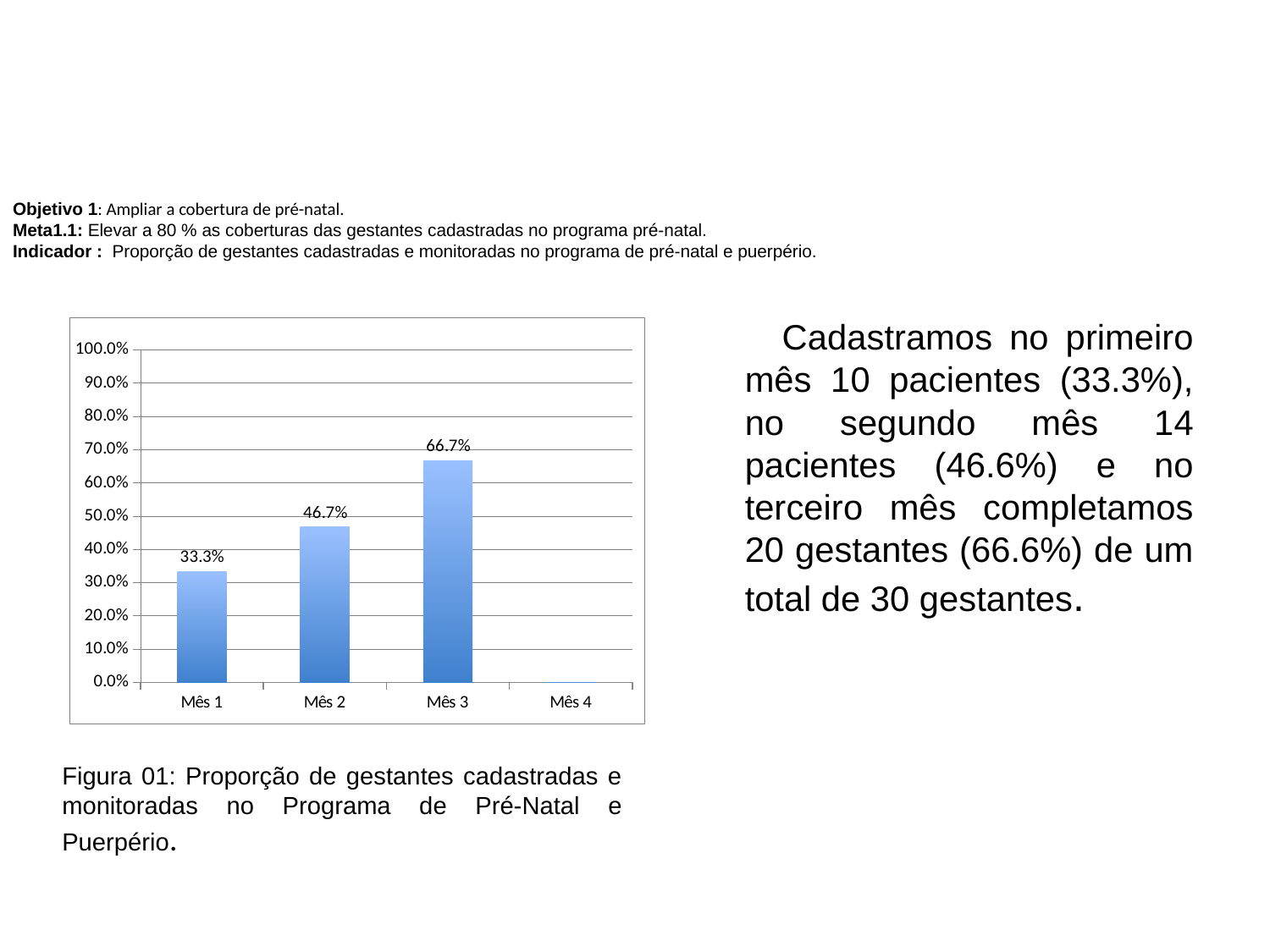
Is the value for Mês 2 greater or less than 40.0%? greater Is the value for Mês 4 greater or less than 10.0%? less What is the difference between the values for Mês 3 and Mês 1? 33.4% What is the value for Mês 2? 46.7% How many months are shown on the x axis? 4 Which month has the highest value? Mês 3 What is the value for Mês 3? 66.7% Do the values rise or fall from Mês 1 to Mês 3? rise What is the difference between the values for Mês 3 and Mês 2? 20.0% What is the value for Mês 1? 33.3% What kind of chart is shown? bar chart Which is larger, the value for Mês 2 or the value for Mês 1? Mês 2